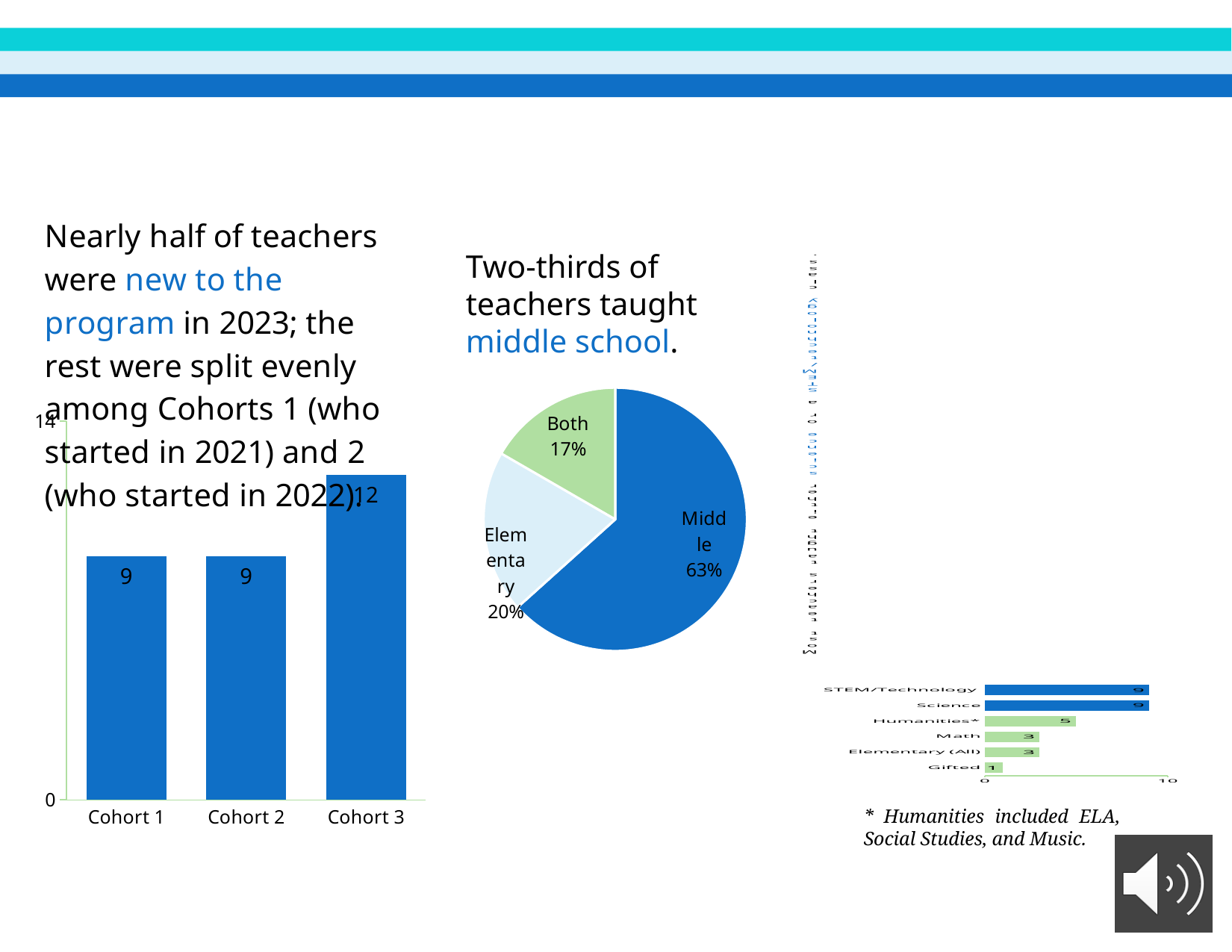
In the pie chart, which slice is the smallest? Both In the pie chart, what share of teachers taught middle school? 63% In the bar chart on the left, what is the value for Cohort 3? 12 How many categories are shown in the horizontal bar chart on the right? 6 How many cohorts are shown in the bar chart on the left? 3 In the horizontal bar chart on the right, what is the value for Humanities*? 5 In the pie chart, what is the percentage for Both? 17% What kind of chart is the chart on the left showing Cohort 1, Cohort 2 and Cohort 3? bar chart In the bar chart on the left, which cohort has the highest value? Cohort 3 In the bar chart on the left, what is the difference between Cohort 3 and Cohort 1? 3 In the horizontal bar chart on the right, which category has the lowest value? Gifted In the pie chart, which is larger, Elementary or Both? Elementary